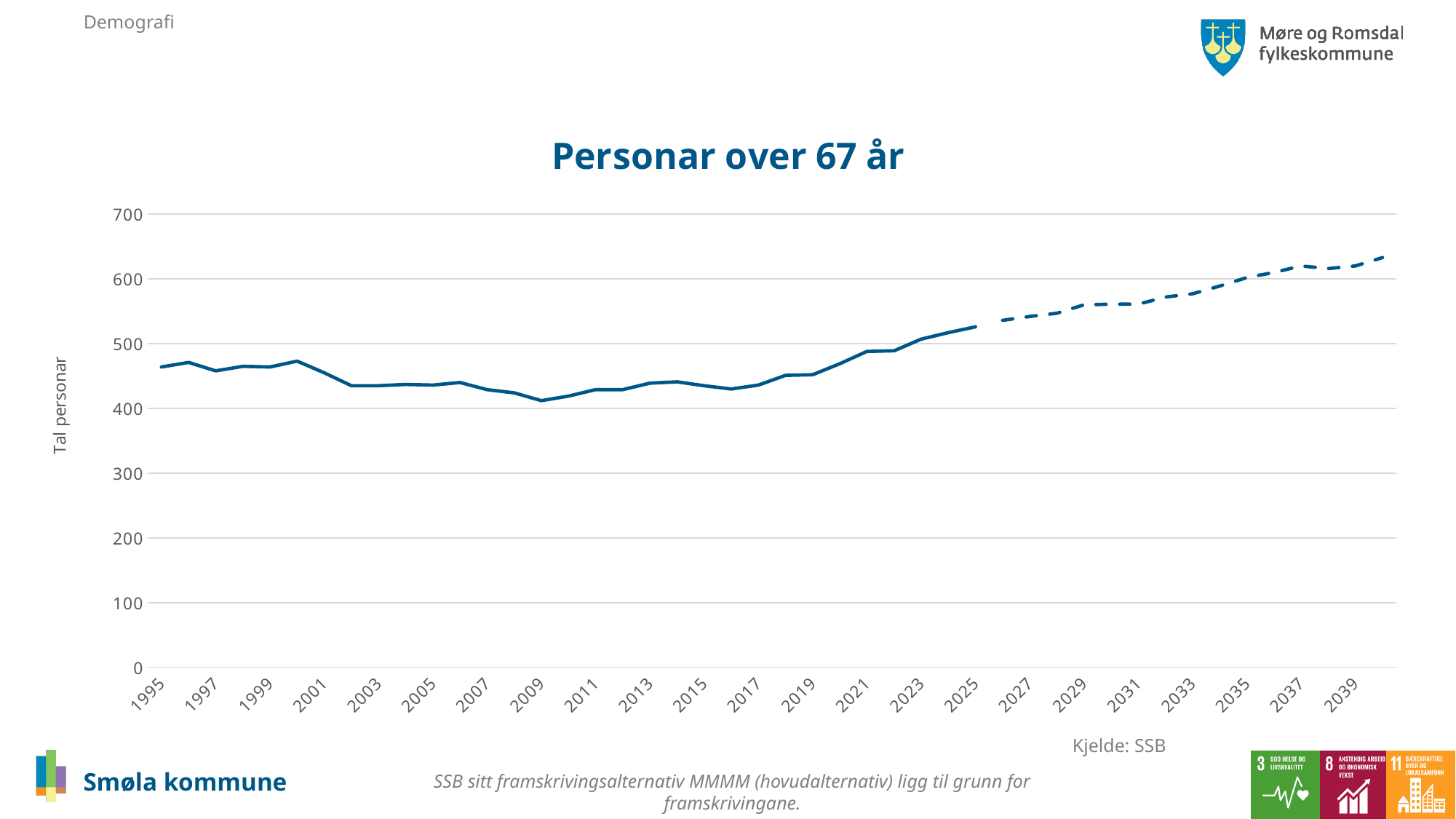
What is the title of the chart? Personar over 67 år Is the value for 1995 greater or less than 500? less Is the value for 2025 greater or less than 600? less In which year does the line reach its lowest value? 2009 Is the value for 2031 greater or less than 500? greater Which is larger, the value for 1995 or the value for 2025? 2025 Which is larger, the value for 2009 or the value for 2039? 2039 Do the values rise or fall along the x axis from 2025 to 2039? rise What kind of chart is shown on the slide? line chart What is the label on the vertical axis of the chart? Tal personar